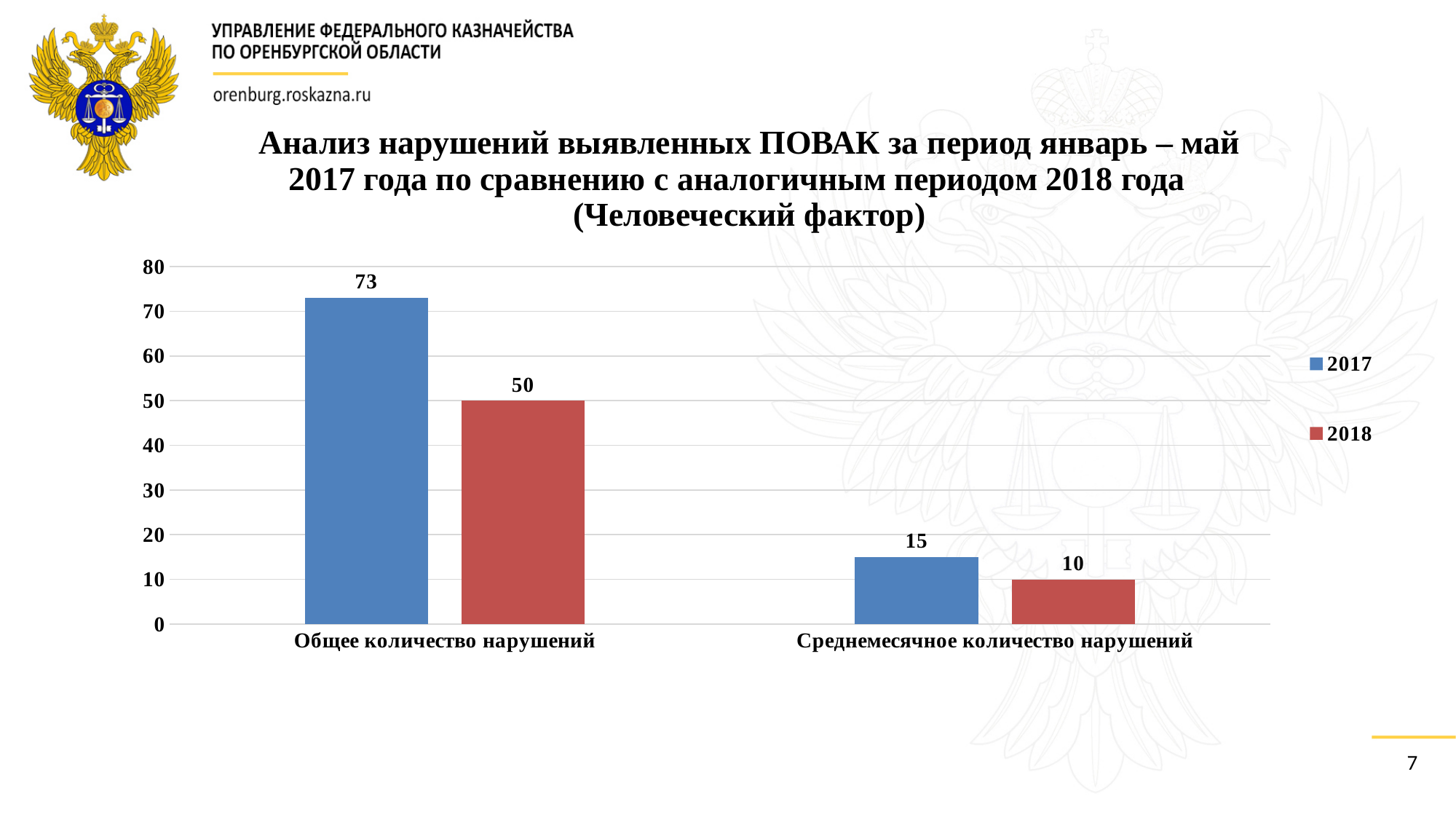
What is the difference between the 2017 and 2018 values for "Общее количество нарушений"? 23 Which bar has the lowest value on the chart? 2018, Среднемесячное количество нарушений Which bar has the highest value on the chart? 2017, Общее количество нарушений What is the value for 2018 in the category "Общее количество нарушений"? 50 What is the value for 2018 in the category "Среднемесячное количество нарушений"? 10 How many categories are shown on the x axis? 2 What is the difference between the 2017 and 2018 values for "Среднемесячное количество нарушений"? 5 What kind of chart is shown on the slide? Bar chart What is the value for 2017 in the category "Среднемесячное количество нарушений"? 15 Which is larger for "Общее количество нарушений": the 2017 value or the 2018 value? 2017 What is the value for 2017 in the category "Общее количество нарушений"? 73 How many series does the legend list? 2